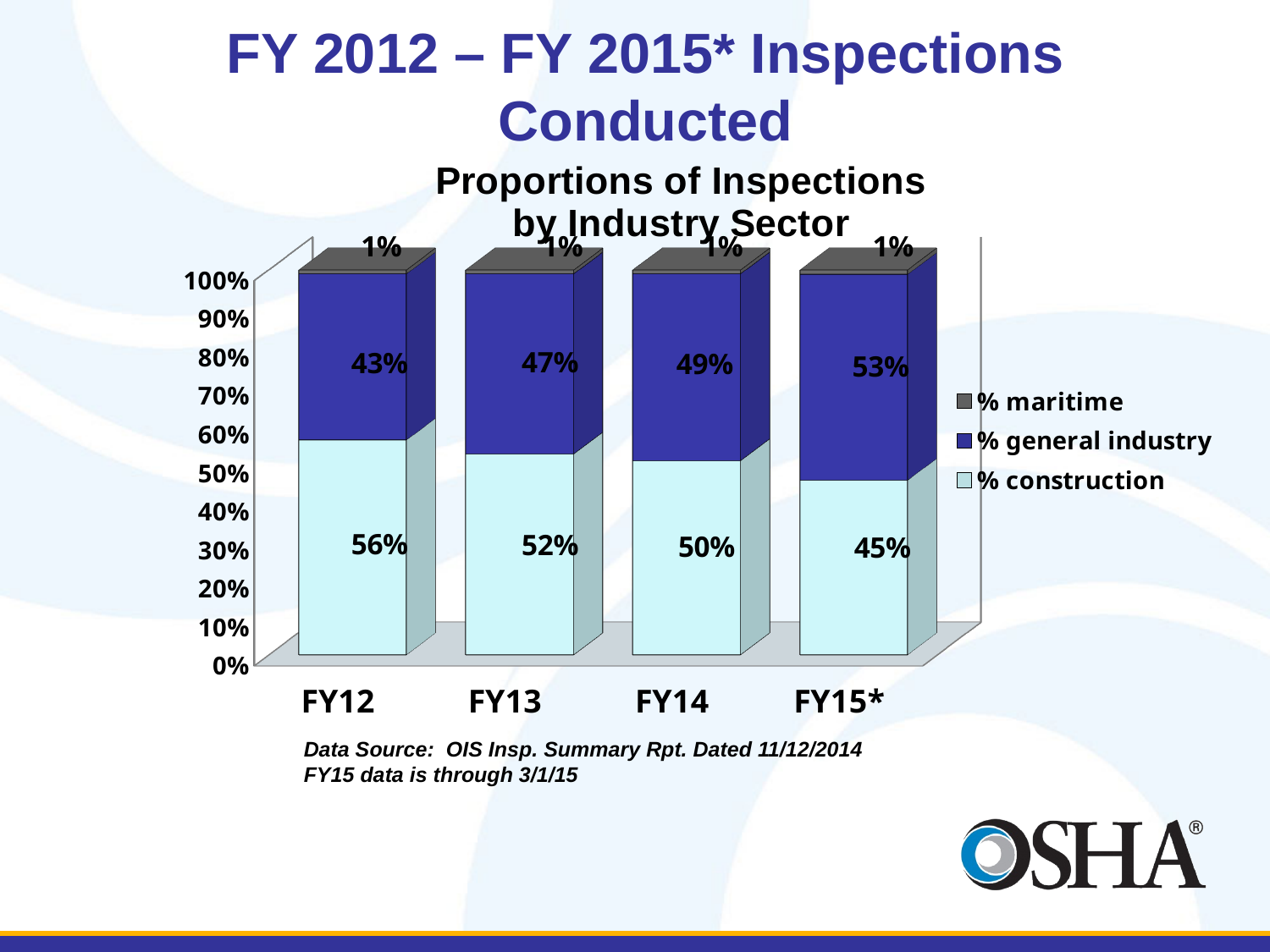
What is the % construction value for FY14? 50% How many series does the legend list? 3 What is the % maritime value for FY13? 1% Does the % general industry value rise or fall from FY12 to FY15*? Rise What is the difference between the % construction values for FY12 and FY15*? 11% Which fiscal year has the highest % general industry value? FY15* What is the % construction value for FY12? 56% What kind of chart is shown? Stacked bar chart Which is larger for FY13: % construction or % general industry? % construction How many fiscal years are shown on the x axis? 4 Which fiscal year has the lowest % construction value? FY15* What is the % general industry value for FY15*? 53%